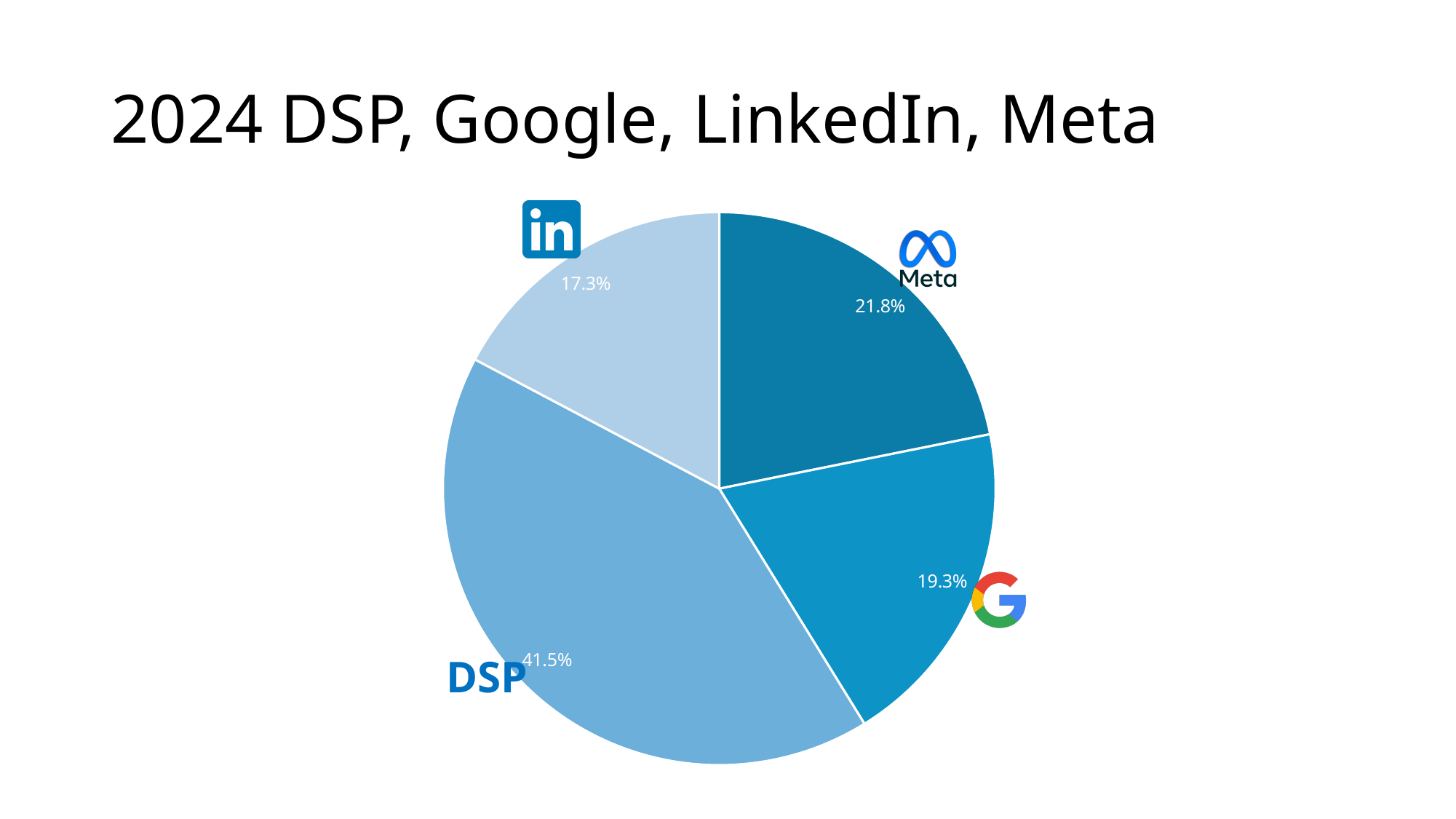
What is the difference in percentage points between the DSP and Meta slices? 19.7 Which is larger, the Meta slice or the Google slice? Meta What share of the pie does LinkedIn hold? 17.3% How many slices does the pie chart have? 4 Which slice is the largest? DSP What kind of chart is shown on the slide? Pie chart What is the title of the slide? 2024 DSP, Google, LinkedIn, Meta What is the difference in percentage points between the Google and LinkedIn slices? 2.0 What share of the pie does DSP hold? 41.5% Which slice is the smallest? LinkedIn What share of the pie does Meta hold? 21.8%